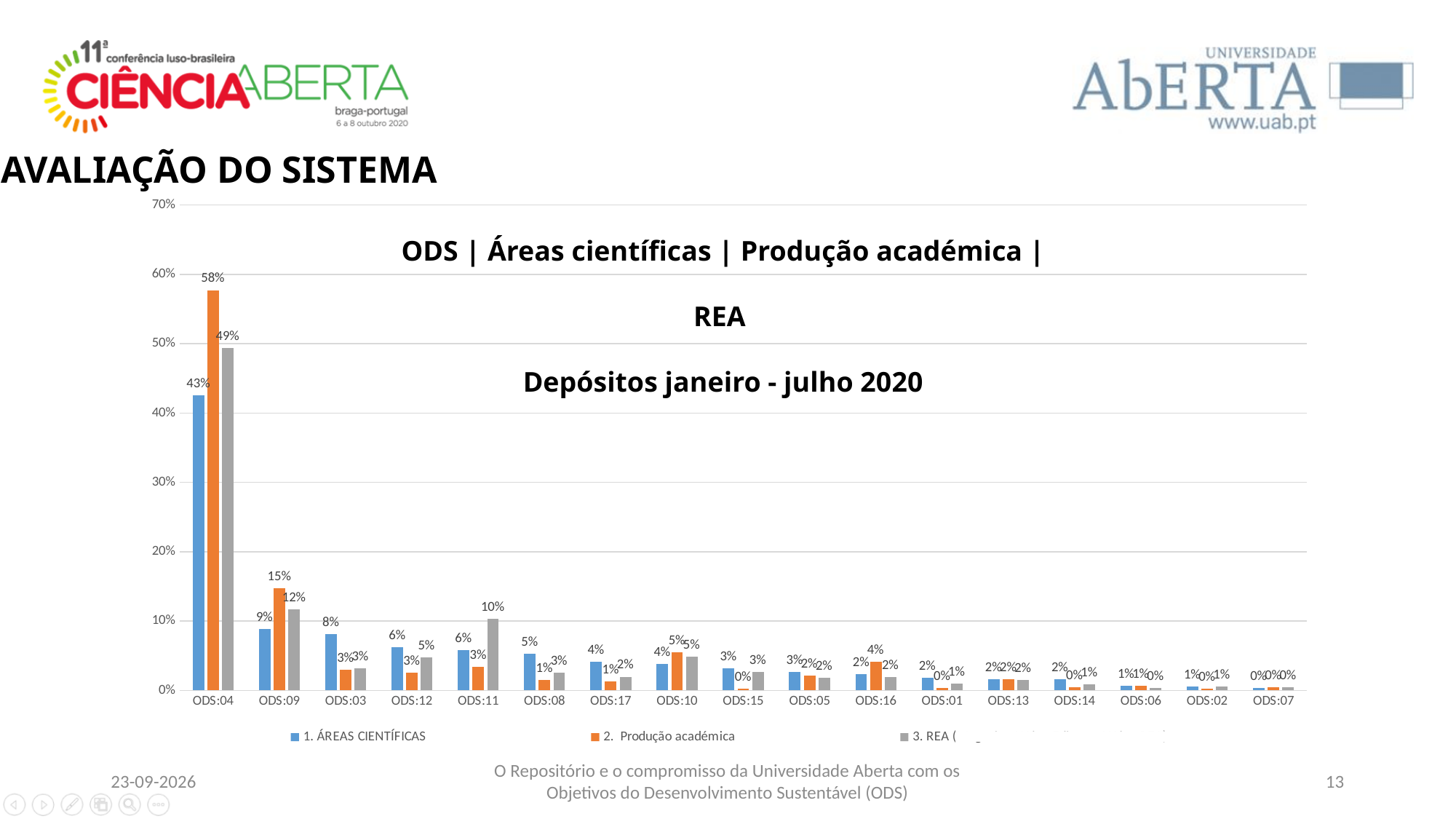
Which ODS category has the highest value in the REA series? ODS:04 What is the value of the ÁREAS CIENTÍFICAS series for ODS:09? 9% What type of chart is shown on the slide? bar chart Which colour represents the Produção académica series in the chart? orange Do the ÁREAS CIENTÍFICAS values generally rise or fall from ODS:04 to ODS:07 along the x axis? fall For ODS:03, which series has the larger value: ÁREAS CIENTÍFICAS or Produção académica? ÁREAS CIENTÍFICAS What is the difference between the Produção académica and ÁREAS CIENTÍFICAS values for ODS:04? 15% How many series does the legend list? 3 How many ODS categories are shown on the x axis? 17 Is the REA value for ODS:04 greater or less than 40%? greater What is the value of the Produção académica series for ODS:04? 58% What is the value of the REA series for ODS:11? 10%